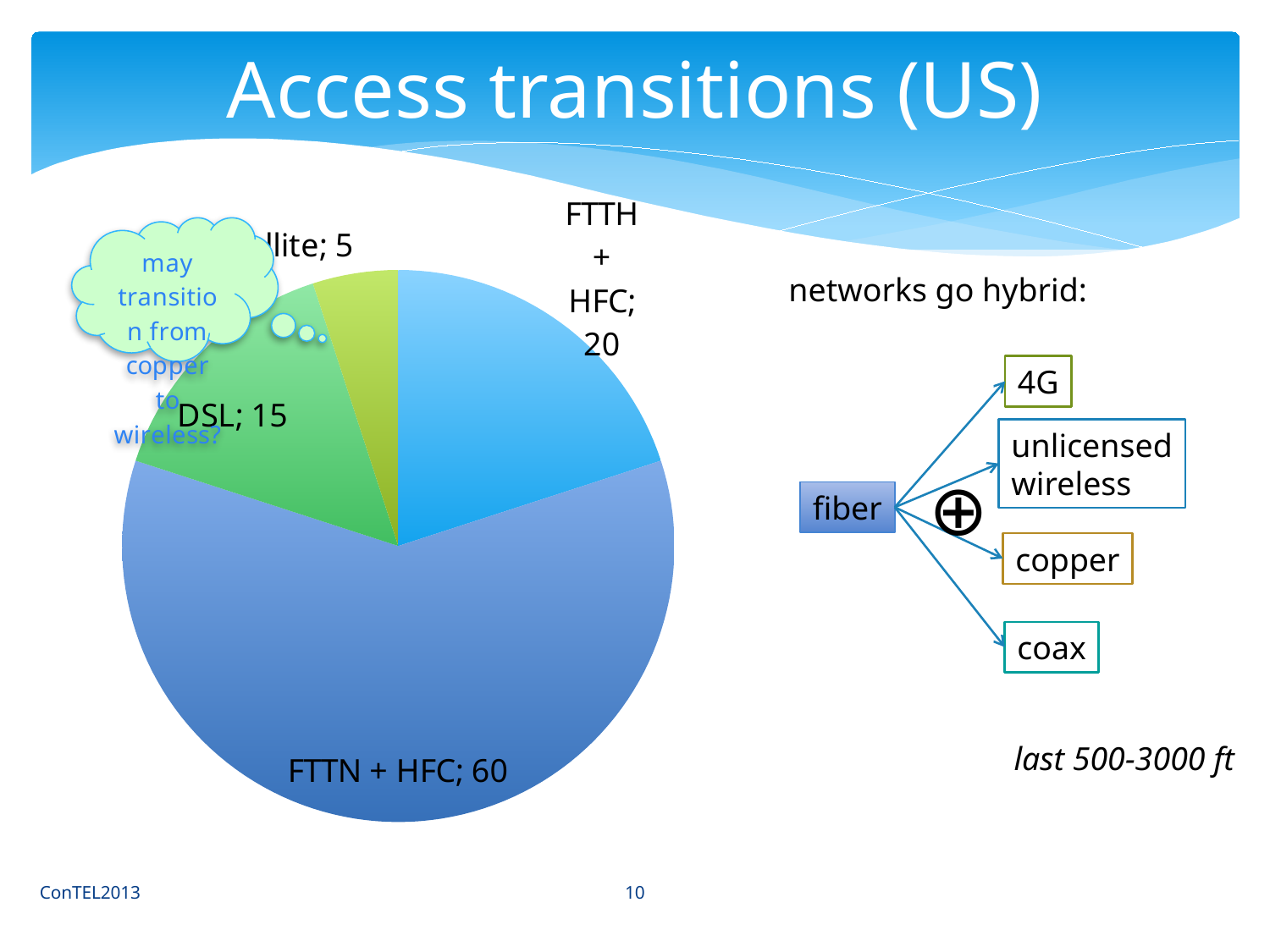
What is the value for the FTTH + HFC slice in the pie chart? 20 What is the total of all the slice values in the pie chart? 100 What is the difference between the FTTH + HFC value and the DSL value in the pie chart? 5 Which is larger in the pie chart, the DSL slice or the FTTH + HFC slice? FTTH + HFC What share of the pie does the FTTN + HFC slice represent? 60% What colour is the FTTN + HFC slice in the pie chart? blue How many slices does the pie chart have? 4 What type of chart is shown on the slide? pie chart What is the value for the DSL slice in the pie chart? 15 What is the difference between the FTTN + HFC value and the FTTH + HFC value in the pie chart? 40 What is the value for the FTTN + HFC slice in the pie chart? 60 Which slice of the pie chart is the largest? FTTN + HFC